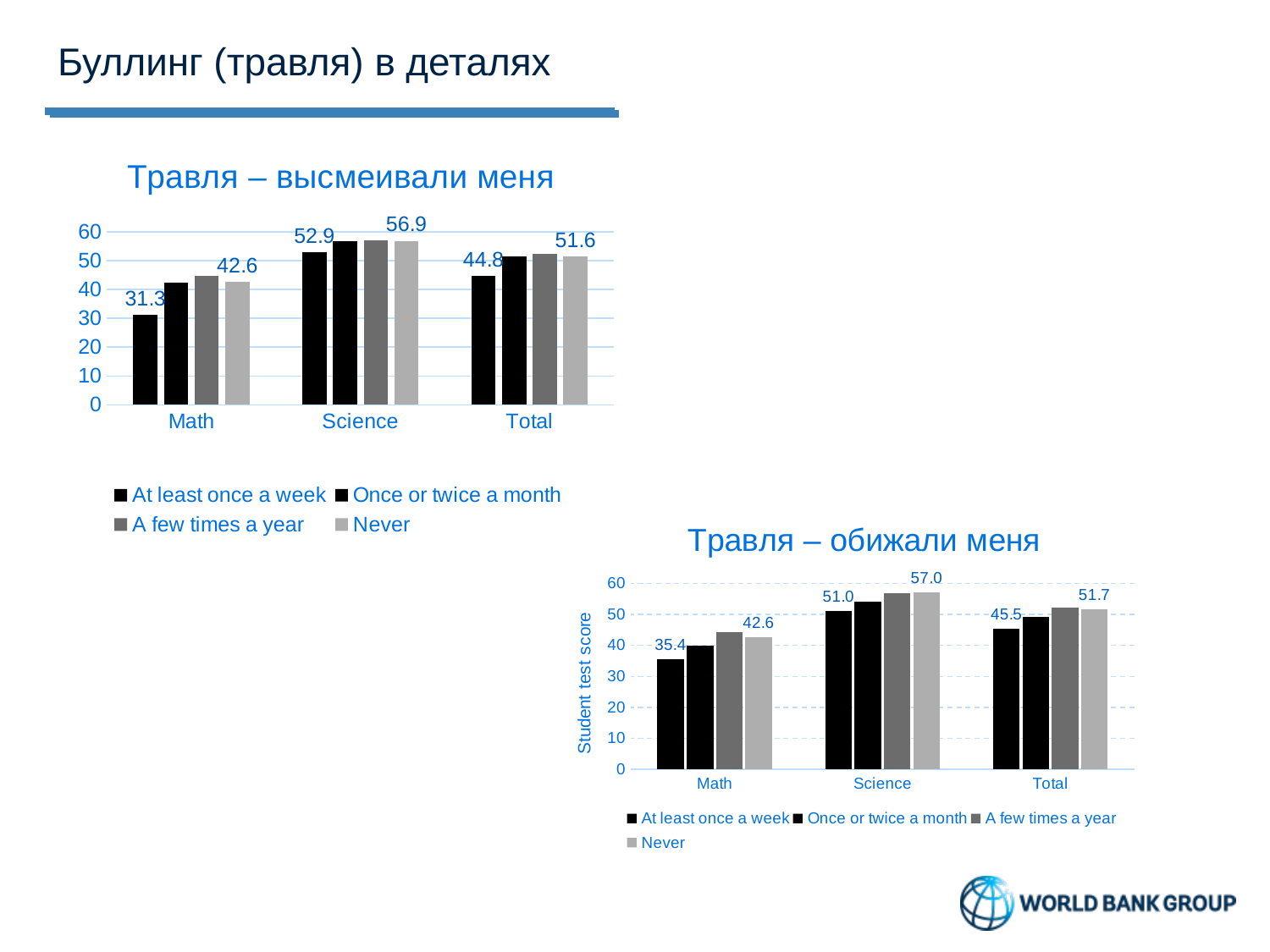
In the 'Травля – обижали меня' chart, which is larger for 'At least once a week': Math or Science? Science In the 'Травля – обижали меня' chart, is the value for Math for 'Once or twice a month' greater or less than 50? less How many categories are shown on the x axis of the 'Травля – высмеивали меня' chart? 3 How many series does the legend of the 'Травля – высмеивали меня' chart list? 4 In the 'Травля – обижали меня' chart, what is the value for Math for 'At least once a week'? 35.4 What is the y-axis title of the 'Травля – обижали меня' chart? Student test score In the 'Травля – обижали меня' chart, what is the value for Total for 'At least once a week'? 45.5 In the 'Травля – высмеивали меня' chart, what is the difference between the Math values for 'Never' and 'At least once a week'? 11.3 In the 'Травля – высмеивали меня' chart, what is the value for Math for 'At least once a week'? 31.3 What kind of chart is the 'Травля – высмеивали меня' chart? bar chart In the 'Травля – высмеивали меня' chart, what is the value for Science for 'At least once a week'? 52.9 In the 'Травля – высмеивали меня' chart, what is the value for Total for 'Never'? 51.6